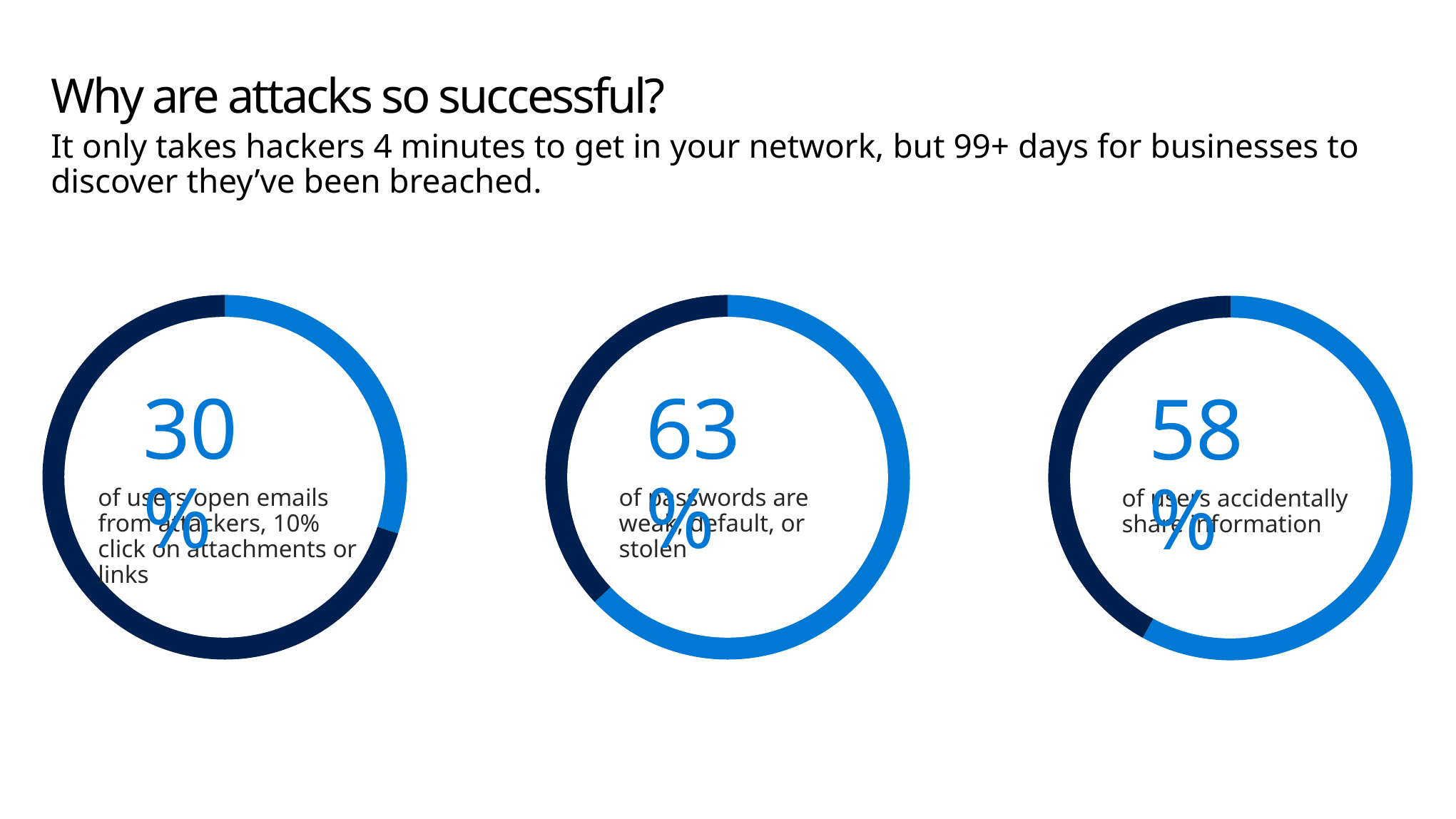
What is the difference between the percentage on the middle chart and the percentage on the right chart? 5 percentage points What kind of chart is used to show each statistic on the slide? Doughnut chart How many ring charts are shown on the slide? 3 Which is larger: the percentage on the left chart or the percentage on the right chart? The right chart (58%) What is the difference between the percentage on the right chart and the percentage on the left chart? 28 percentage points On the middle chart, what percentage of passwords are weak, default, or stolen? 63% Which of the three charts shows the lowest percentage? The left chart (users open emails from attackers), 30% On the right chart, what percentage of users accidentally share information? 58% What colour is used for the filled (highlighted) portion of each ring? Light blue Which of the three charts shows the highest percentage? The middle chart (passwords weak, default, or stolen), 63% On the left chart, what percentage of users open emails from attackers? 30% What is the difference between the percentage on the middle chart and the percentage on the left chart? 33 percentage points